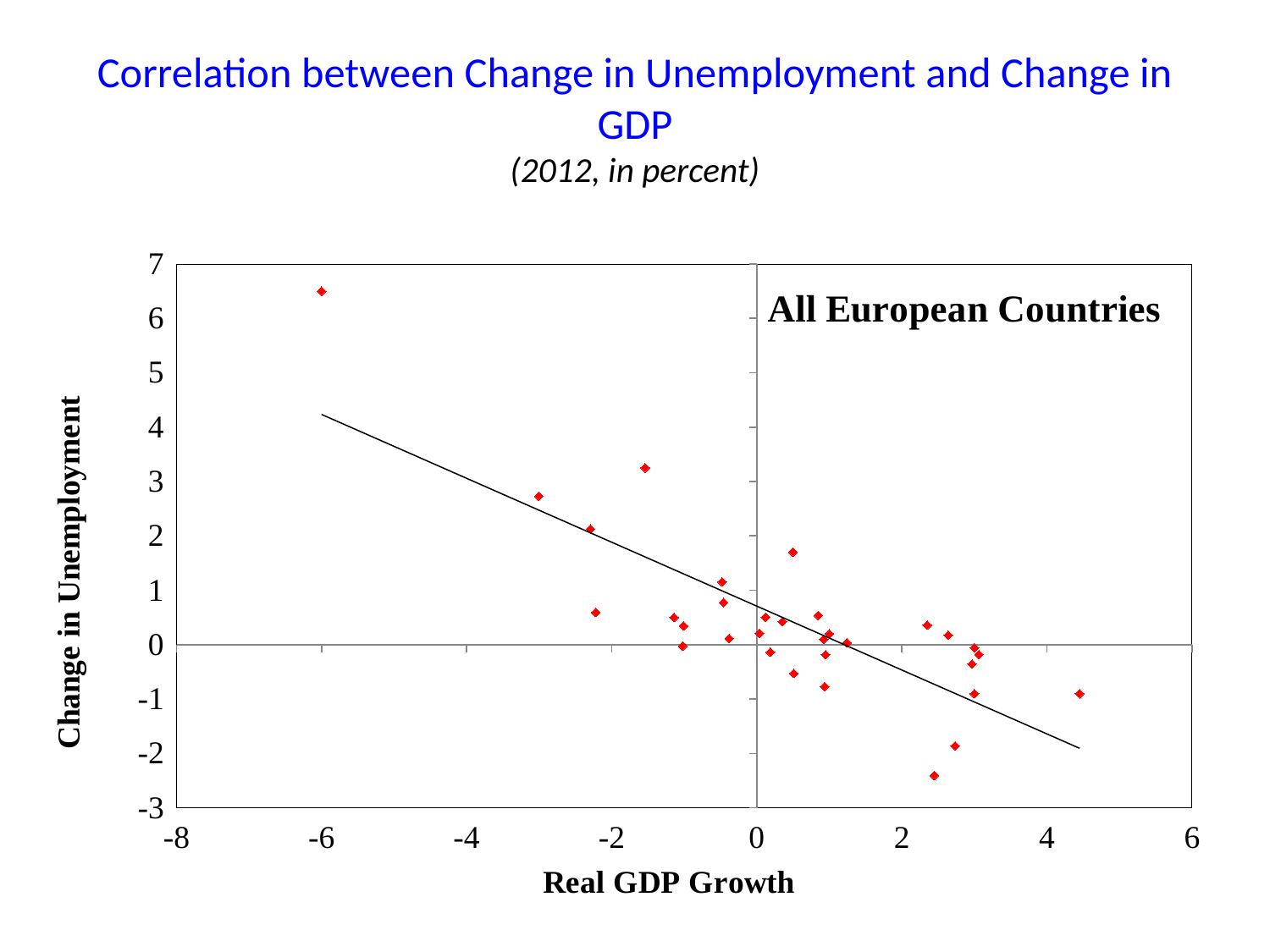
Is the Change in Unemployment of the lowest point in the chart greater or less than -2? less Are the points with negative Real GDP Growth mostly above or below a Change in Unemployment of 0? above Is the Real GDP Growth of the highest point in the chart greater or less than -4? less What is the title of the x axis? Real GDP Growth As Real GDP Growth increases along the x axis, does Change in Unemployment tend to rise or fall? fall Is the value of the fitted line at a Real GDP Growth of 0 greater or less than 0? greater What label is printed inside the plot area in the upper right? All European Countries Does the fitted line in the chart slope upward or downward from left to right? downward What kind of chart is shown on the slide? scatter plot